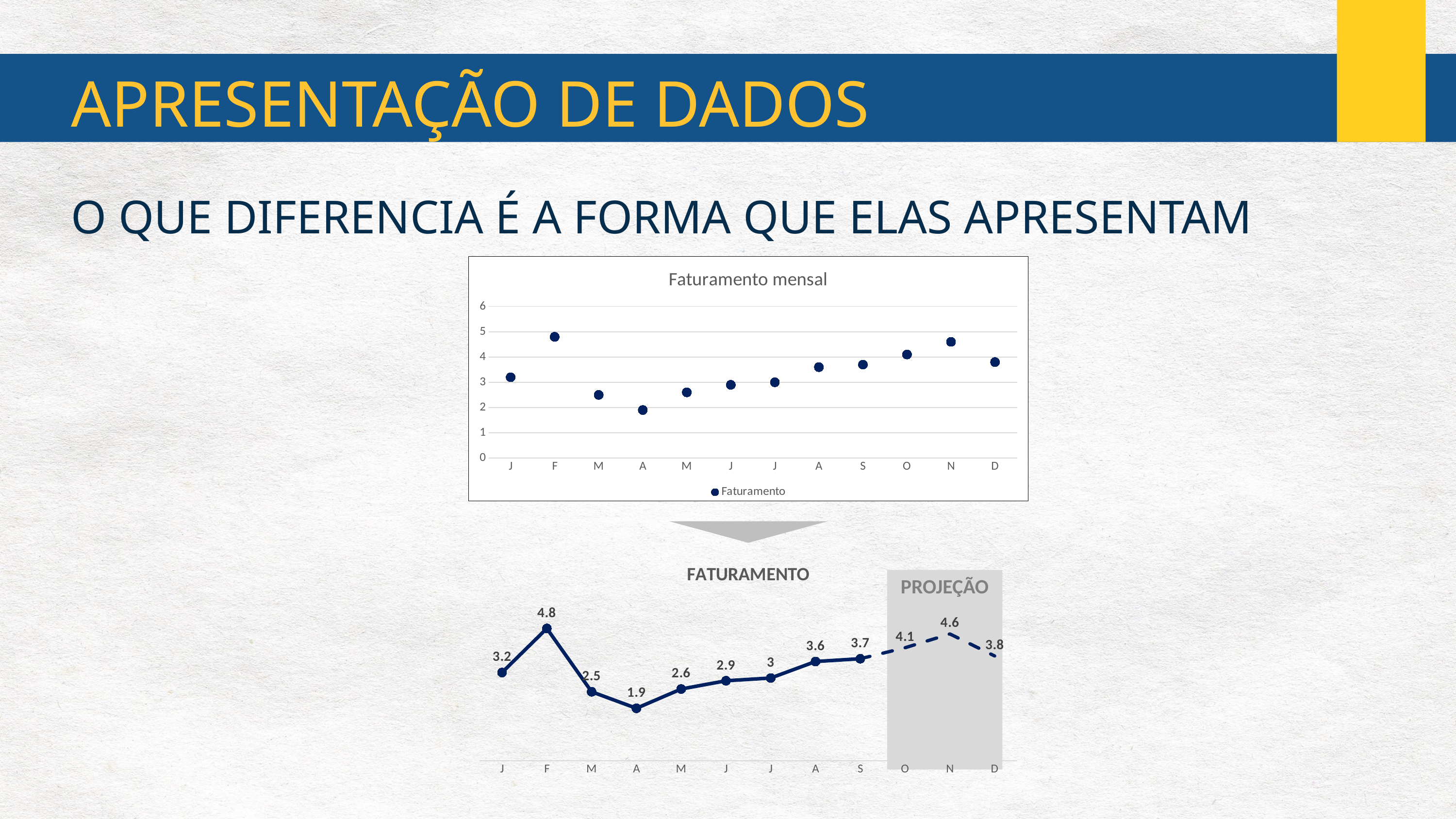
In the bottom chart titled FATURAMENTO, what is the difference between the values for F and S? 1.1 In the bottom chart titled FATURAMENTO, how many data points are plotted? 12 In the bottom chart titled FATURAMENTO, what is the lowest value plotted? 1.9 In the bottom chart titled FATURAMENTO, what is the value for D? 3.8 In the top chart titled Faturamento mensal, is the value for F greater or less than 4? greater In the bottom chart titled FATURAMENTO, what label is shown on the shaded area covering O, N and D? PROJEÇÃO In the bottom chart titled FATURAMENTO, which is larger, the value for O or the value for D? O In the bottom chart titled FATURAMENTO, what is the value for N? 4.6 In the bottom chart titled FATURAMENTO, which month has the highest value? F In the bottom chart titled FATURAMENTO, what is the value for S? 3.7 In the bottom chart titled FATURAMENTO, what is the value for F? 4.8 In the top chart titled Faturamento mensal, what series name does the legend show? Faturamento